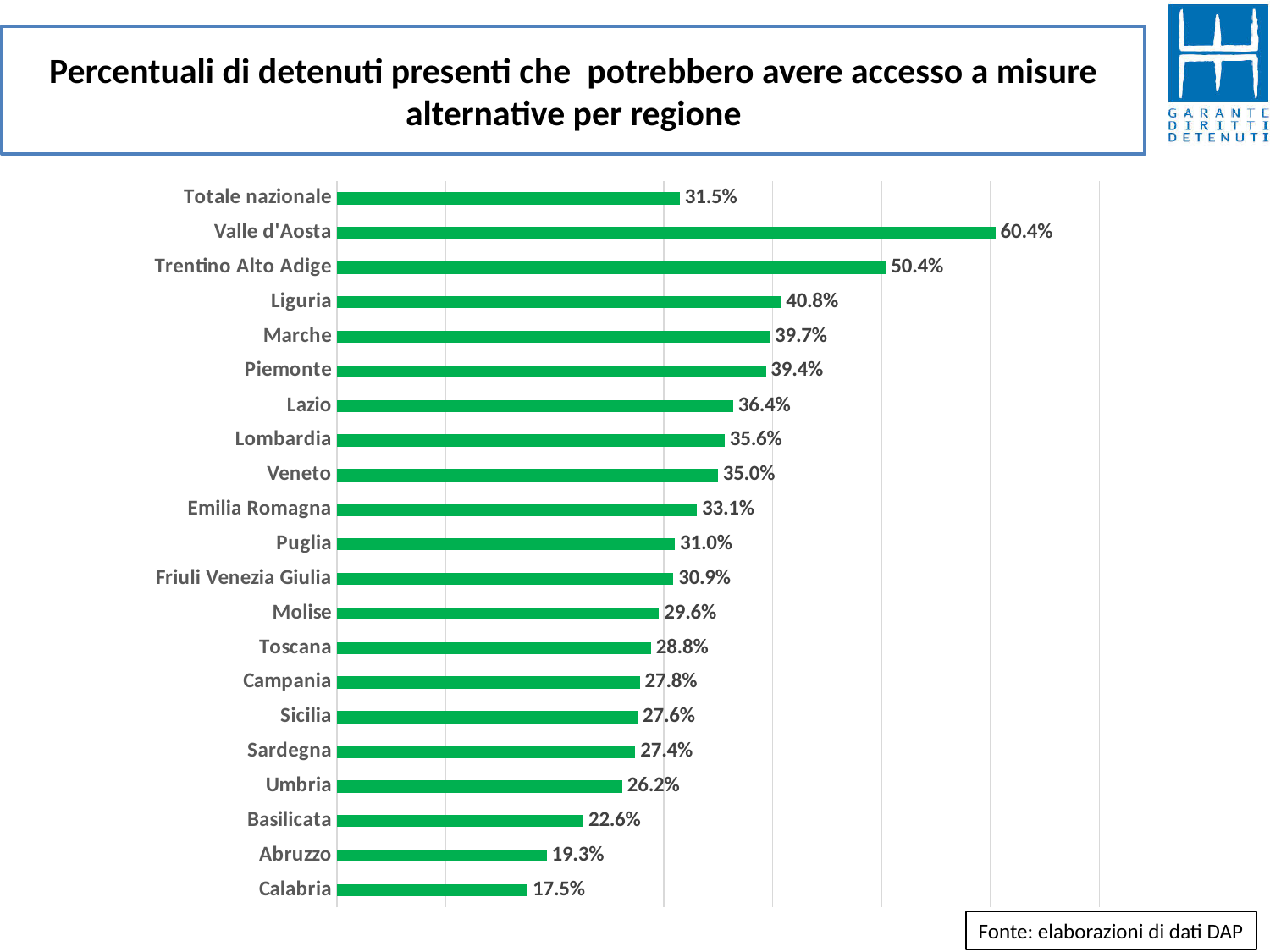
What is the difference between Valle d'Aosta and Trentino Alto Adige? 10.0% What is the value for Lombardia? 35.6% Which is larger, the value for Abruzzo or the value for Basilicata? Basilicata Which region has the highest percentage? Valle d'Aosta What is the difference between Liguria and Calabria? 23.3% Which region has the lowest percentage? Calabria What source is cited for the data on the slide? Fonte: elaborazioni di dati DAP What kind of chart is shown on the slide? Bar chart What is the value for Valle d'Aosta? 60.4% How many bars are shown in the chart? 21 Which is larger, the value for Lazio or the value for Veneto? Lazio What is the value for Totale nazionale? 31.5%